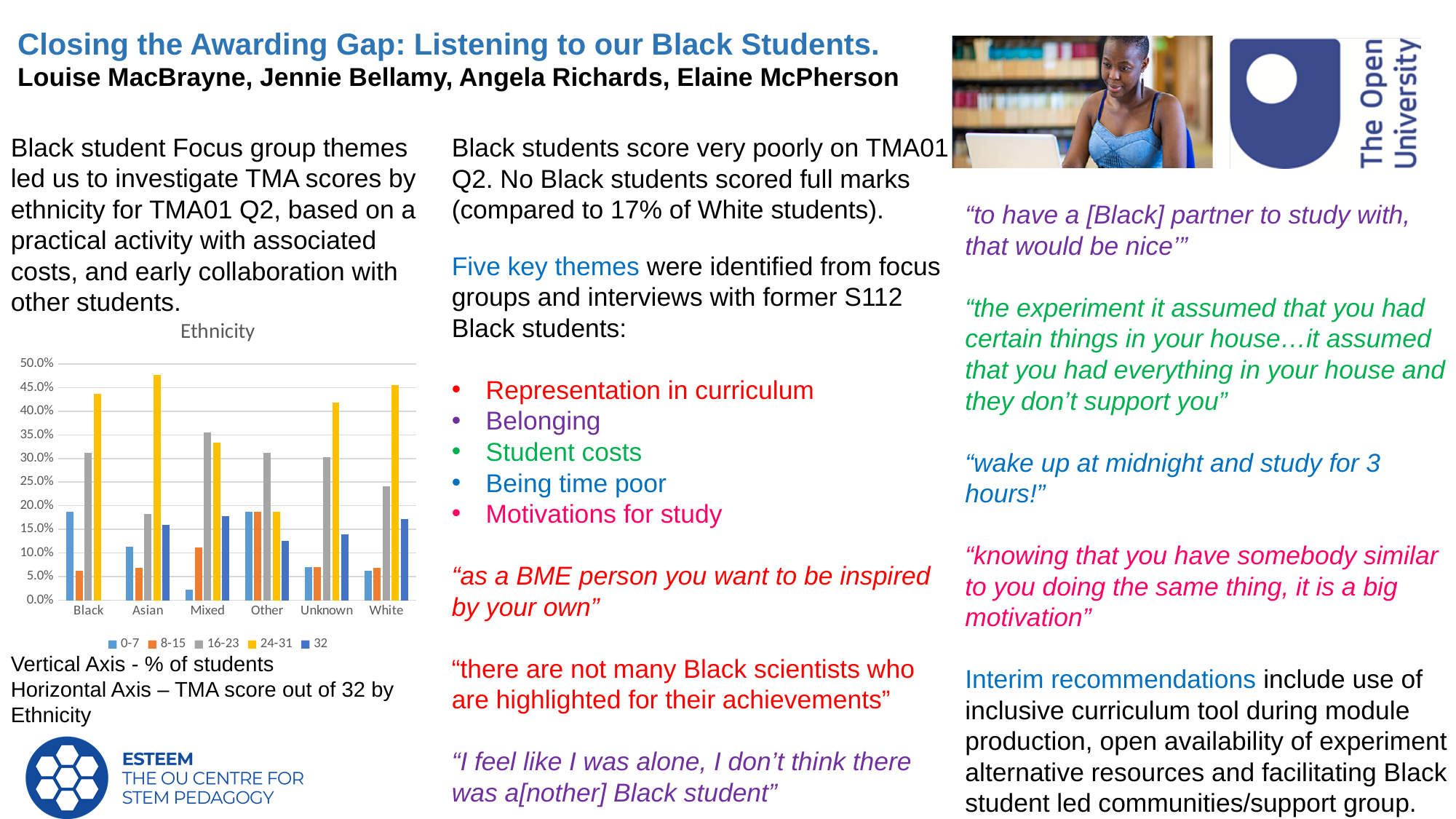
How many ethnicity categories are shown on the x axis of the chart? 6 How many series does the chart's legend list? 5 Which ethnicity category has the lowest value for the 24-31 series? Other Which is larger for Black students: the 0-7 series or the 8-15 series? 0-7 Which ethnicity category has the highest value for the 24-31 series? Asian What kind of chart is shown on the slide? bar chart What is the title of the chart? Ethnicity Is the value for the 16-23 series for Mixed students greater or less than 30%? greater Which is larger for White students: the 24-31 series or the 16-23 series? 24-31 Is the value for the 32 series for White students greater or less than 20%? less Is the value for the 24-31 series for Black students greater or less than 40%? greater Which ethnicity category has the lowest value for the 0-7 series? Mixed